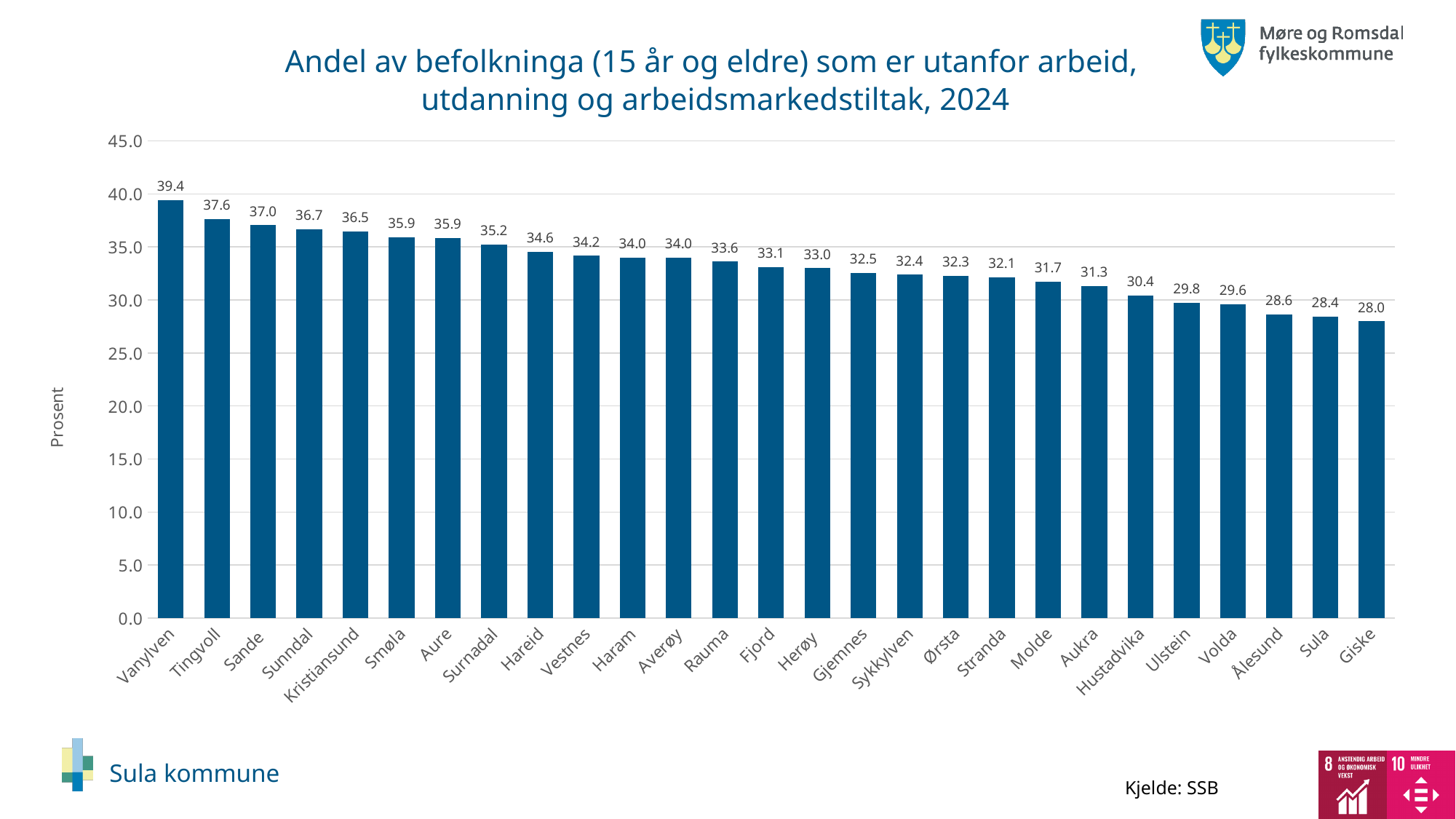
Which has a larger value, Kristiansund or Hustadvika? Kristiansund Which municipality has the lowest value? Giske Which municipality has the highest value? Vanylven What is the value for Molde? 31.7 Is the value for Ulstein greater or less than 30.0? less What kind of chart is shown on the slide? bar chart What is the value for Vanylven? 39.4 What is the difference between the values for Vanylven and Giske? 11.4 How many municipalities are shown on the chart? 27 What is the difference between the values for Ålesund and Sula? 0.2 What is the label on the vertical axis? Prosent What is the value for Sula? 28.4